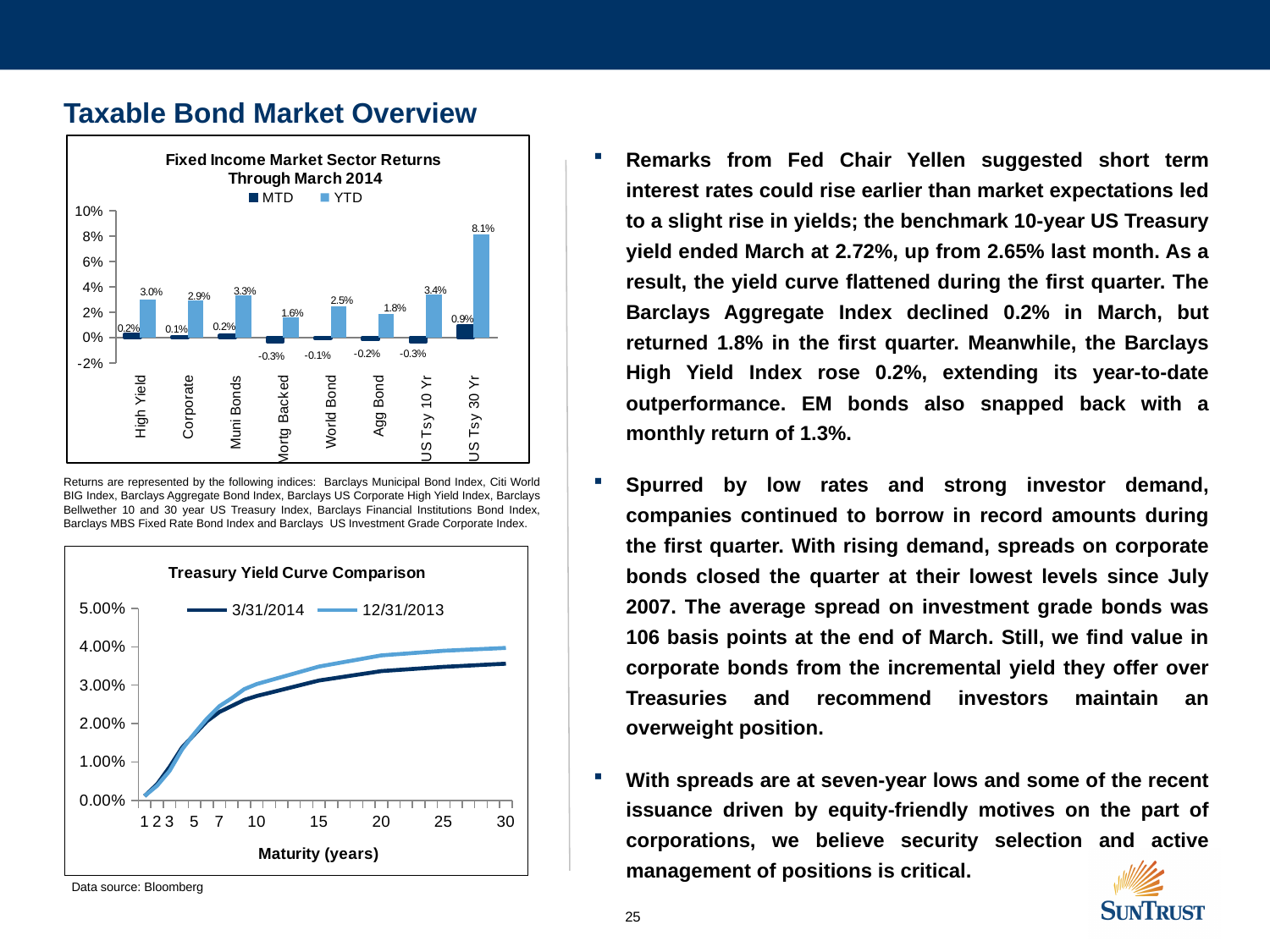
In the Fixed Income Market Sector Returns chart, which sector has the lowest YTD return? Mortg Backed In the Treasury Yield Curve Comparison chart, is the 3/31/2014 yield at 30 years greater or less than 4.00%? less In the Fixed Income Market Sector Returns chart, what is the difference between the YTD returns of US Tsy 30 Yr and US Tsy 10 Yr? 4.7% How many sectors are shown in the Fixed Income Market Sector Returns chart? 8 What kind of chart is the Fixed Income Market Sector Returns chart? Bar chart In the Fixed Income Market Sector Returns chart, what is the MTD return for Agg Bond? -0.2% In the Fixed Income Market Sector Returns chart, which is larger, the YTD return for Muni Bonds or for Corporate? Muni Bonds In the Treasury Yield Curve Comparison chart, do the yields rise or fall as maturity increases? rise What is the x-axis title of the Treasury Yield Curve Comparison chart? Maturity (years) In the Fixed Income Market Sector Returns chart, which sector has the highest YTD return? US Tsy 30 Yr In the Fixed Income Market Sector Returns chart, what is the YTD return for US Tsy 30 Yr? 8.1% How many series does the legend of the Fixed Income Market Sector Returns chart list? 2